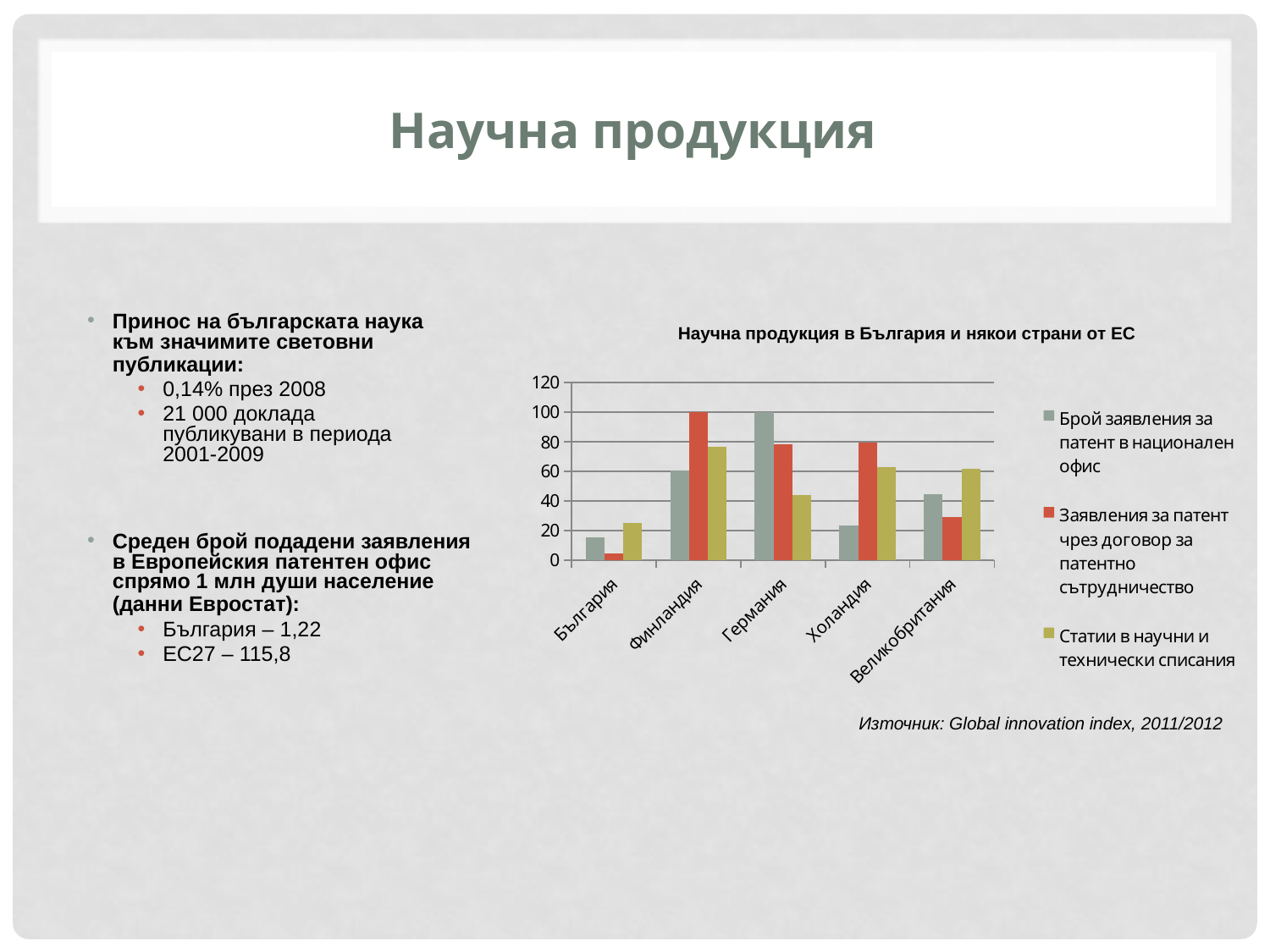
What kind of chart is shown on the slide? Bar chart What is the title of the chart? Научна продукция в България и някои страни от ЕС Which country has the highest value for 'Заявления за патент чрез договор за патентно сътрудничество'? Финландия Which country has the highest value for 'Брой заявления за патент в национален офис'? Германия How many countries are shown on the x axis of the chart? 5 Is the value for 'Брой заявления за патент в национален офис' for България greater or less than 20? less Which country has the lowest value for 'Заявления за патент чрез договор за патентно сътрудничество'? България How many series does the chart legend list? 3 Is the value for 'Статии в научни и технически списания' for Германия greater or less than 40? greater Which country has the highest value for 'Статии в научни и технически списания'? Финландия Which is larger: the 'Заявления за патент чрез договор за патентно сътрудничество' value for Финландия or for Германия? Финландия Is the value for 'Заявления за патент чрез договор за патентно сътрудничество' for Великобритания greater or less than 40? less